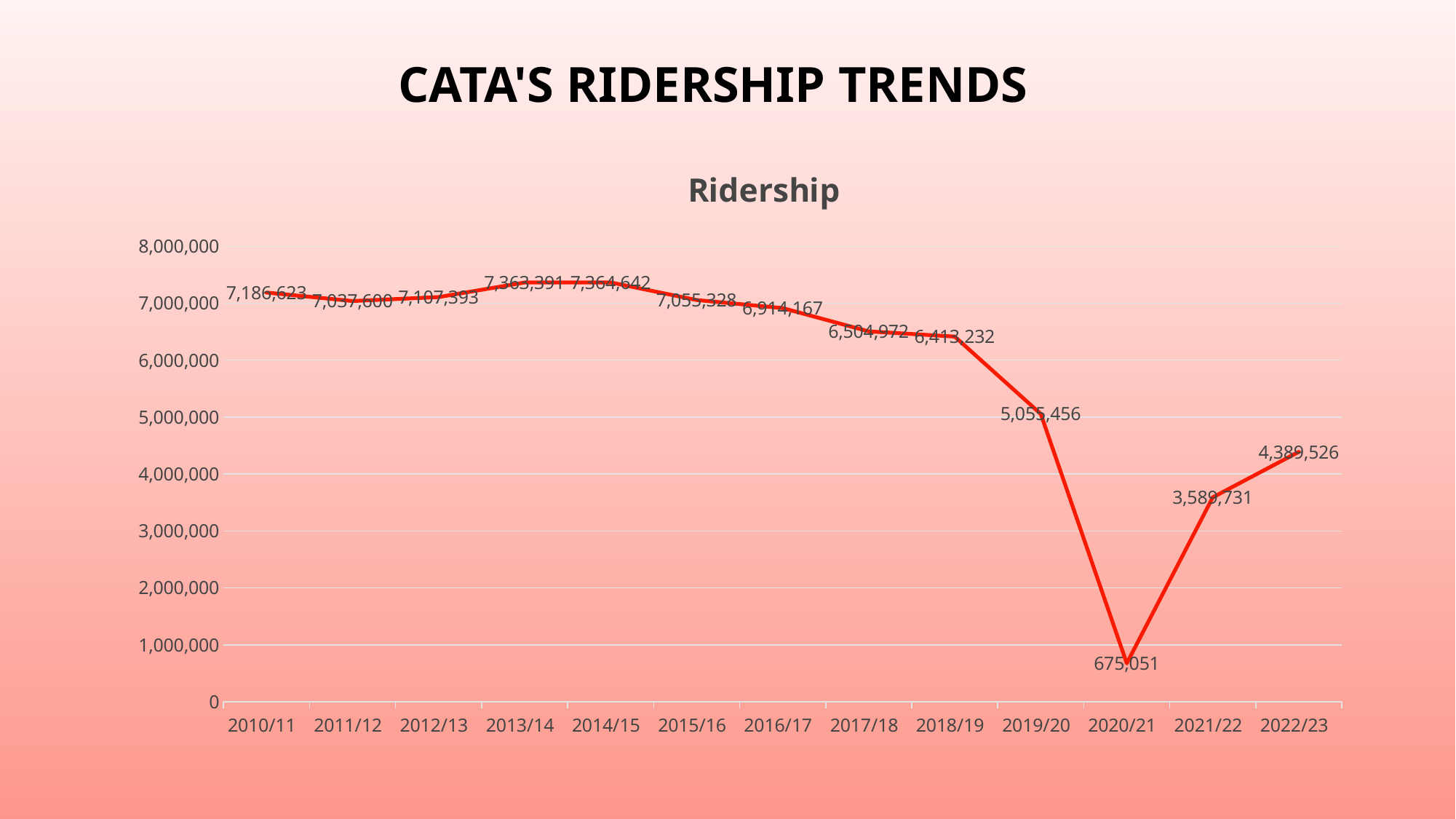
What is the difference in ridership between 2019/20 and 2020/21? 4,380,405 What is the difference in ridership between 2017/18 and 2018/19? 91,740 How many years are plotted on the chart? 13 What kind of chart is shown on the slide? line chart What is the ridership value for 2020/21? 675,051 What is the ridership value for 2011/12? 7,037,600 Does ridership rise or fall from 2014/15 to 2020/21? fall Is the ridership value for 2021/22 greater or less than 3,000,000? greater Which year has higher ridership, 2019/20 or 2021/22? 2019/20 Which year has the lowest ridership? 2020/21 What is the ridership value for 2019/20? 5,055,456 What is the ridership value for 2017/18? 6,504,972